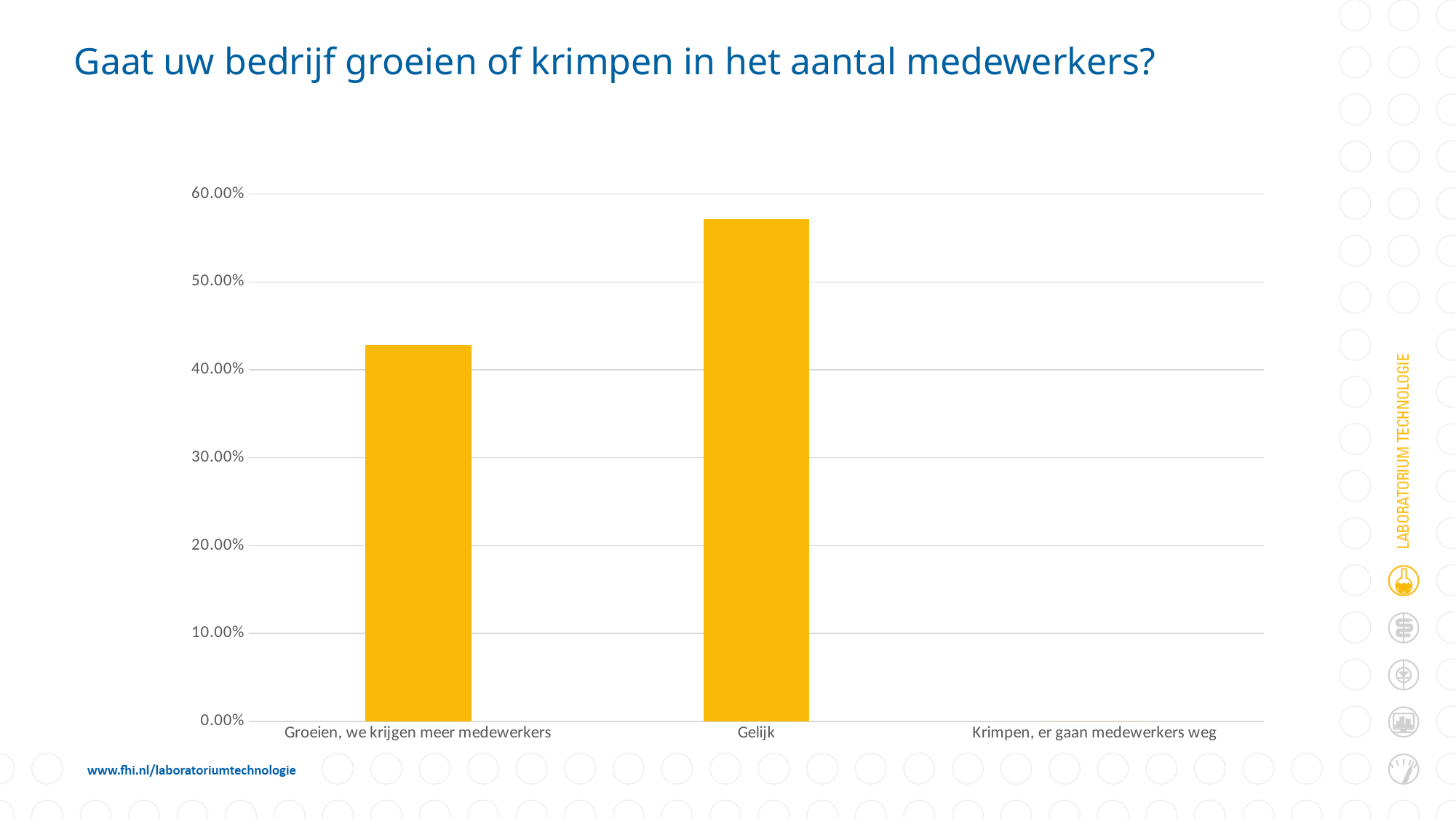
Is the value for 'Groeien, we krijgen meer medewerkers' greater or less than 50.00%? less Which category has the highest value in the chart? Gelijk What colour are the bars in the chart? yellow Is the value for 'Gelijk' greater or less than 60.00%? less What kind of chart is shown on the slide? bar chart Is the value for 'Gelijk' greater or less than 50.00%? greater What is the value shown for 'Krimpen, er gaan medewerkers weg'? 0.00% What is the title of the slide containing the chart? Gaat uw bedrijf groeien of krimpen in het aantal medewerkers? Which is larger: the value for 'Gelijk' or the value for 'Groeien, we krijgen meer medewerkers'? Gelijk Which category has the lowest value in the chart? Krimpen, er gaan medewerkers weg How many categories are shown on the x axis of the chart? 3